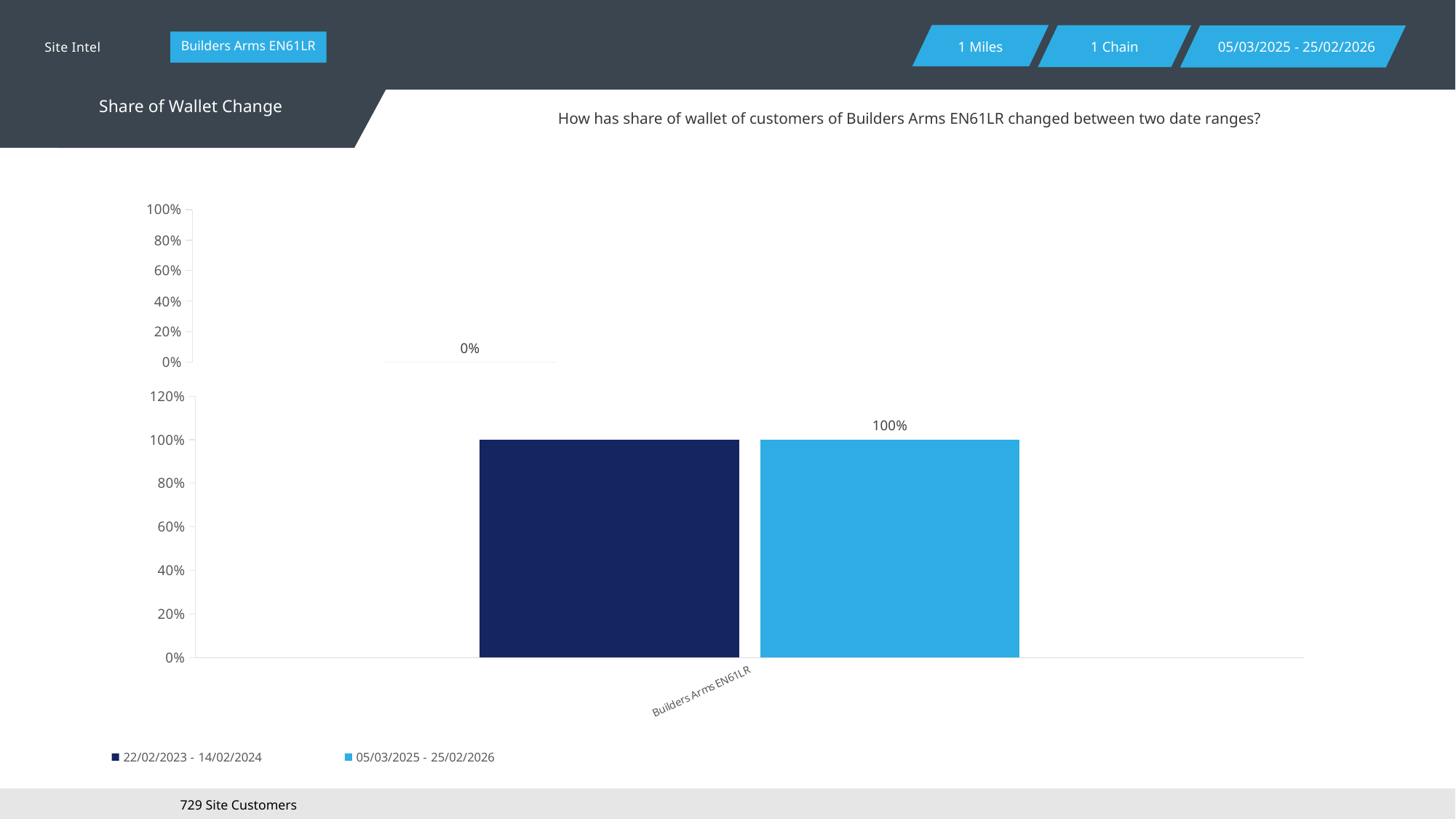
What kind of chart is the bottom chart? bar chart What value is labelled on the top chart? 0% In the bottom chart, what is the difference between the 05/03/2025 - 25/02/2026 value and the 22/02/2023 - 14/02/2024 value for Builders Arms EN61LR? 0% In the bottom chart, what is the value for the 05/03/2025 - 25/02/2026 series for Builders Arms EN61LR? 100% What is the category label on the x axis of the bottom chart? Builders Arms EN61LR In the bottom chart, is the value for the 22/02/2023 - 14/02/2024 series greater or less than 120%? less In the bottom chart, is the value for the 05/03/2025 - 25/02/2026 series greater or less than 80%? greater How many categories are shown on the x axis of the bottom chart? 1 Which legend entry in the bottom chart is shown in dark navy? 22/02/2023 - 14/02/2024 How many series does the legend of the bottom chart list? 2 In the bottom chart, what value does the 22/02/2023 - 14/02/2024 bar for Builders Arms EN61LR reach on the axis? 100% What is the highest tick value on the y axis of the bottom chart? 120%